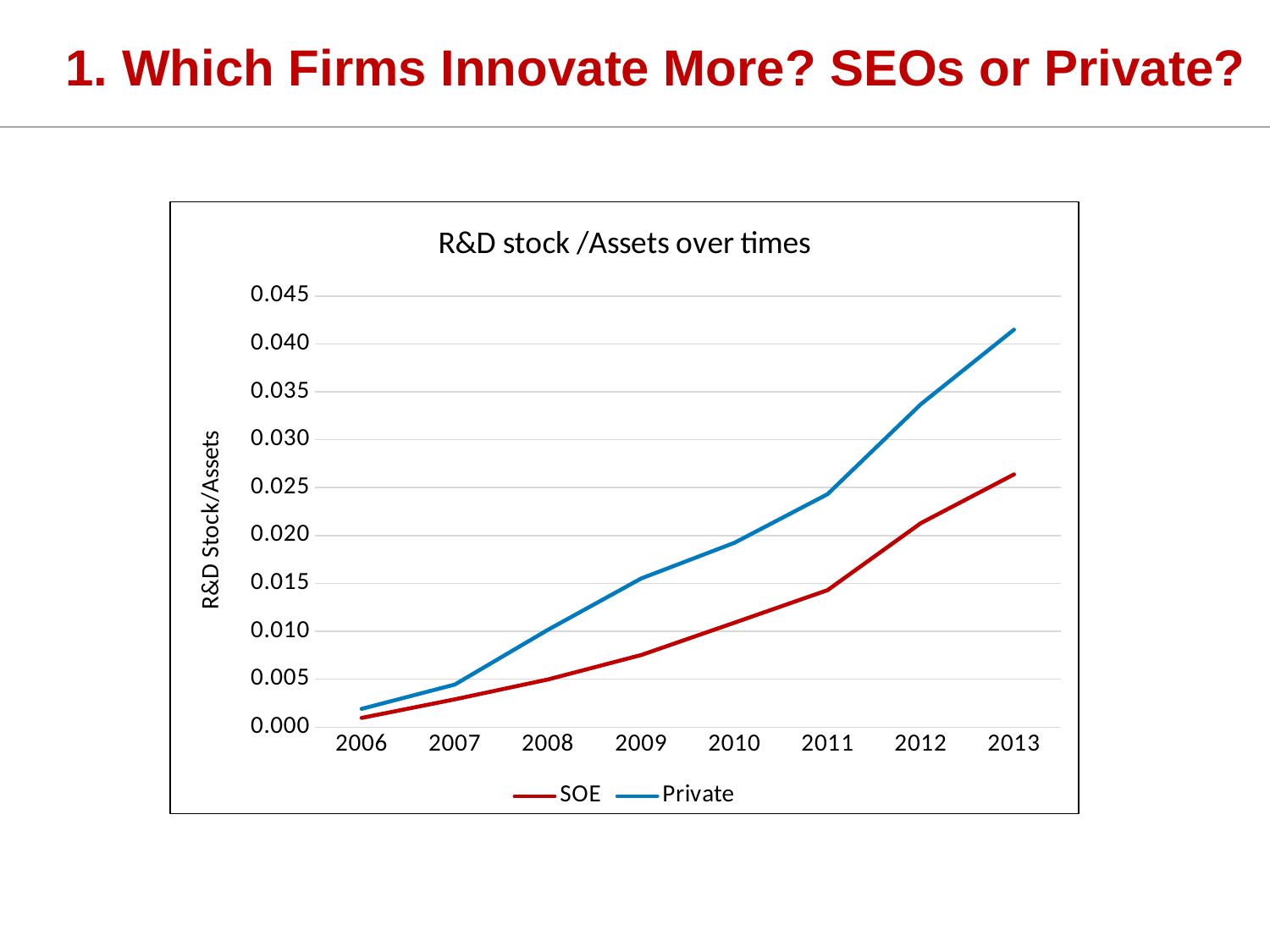
In which year does the SOE series reach its highest value? 2013 Which series has the higher value in 2013, SOE or Private? Private Is the value for Private in 2011 greater or less than 0.020? greater Is the value for SOE in 2009 greater or less than 0.010? less What kind of chart is shown on the slide? line chart Do the values for the Private series rise or fall from 2006 to 2013? rise What is the title of the chart? R&D stock /Assets over times What is the label of the y axis? R&D Stock/Assets Is the value for Private in 2013 greater or less than 0.040? greater How many years are shown on the x axis? 8 How many series does the legend list? 2